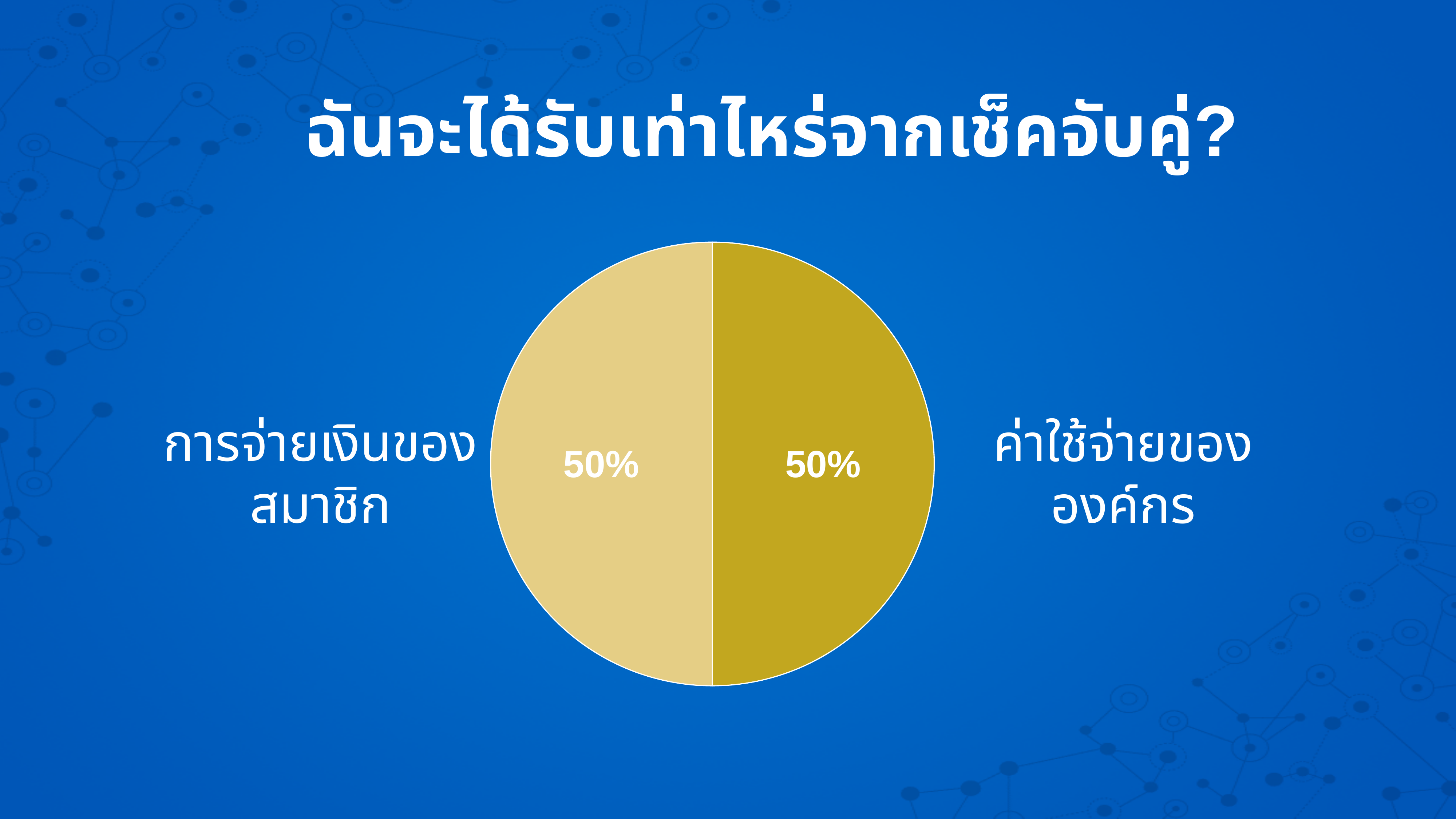
What share of the pie chart does การจ่ายเงินของสมาชิก represent? 50% What is the title of the slide containing the pie chart? ฉันจะได้รับเท่าไหร่จากเช็คจับคู่? What is the value shown for the slice labelled ค่าใช้จ่ายขององค์กร? 50% What share of the pie chart does ค่าใช้จ่ายขององค์กร represent? 50% What is the total of the two slices shown in the pie chart? 100% How many slices does the pie chart have? 2 What kind of chart is shown on the slide? pie chart What is the difference between the share for ค่าใช้จ่ายขององค์กร and the share for การจ่ายเงินของสมาชิก? 0% Which slice is drawn in the darker gold colour, การจ่ายเงินของสมาชิก or ค่าใช้จ่ายขององค์กร? ค่าใช้จ่ายขององค์กร What is the value shown for the slice labelled การจ่ายเงินของสมาชิก? 50%